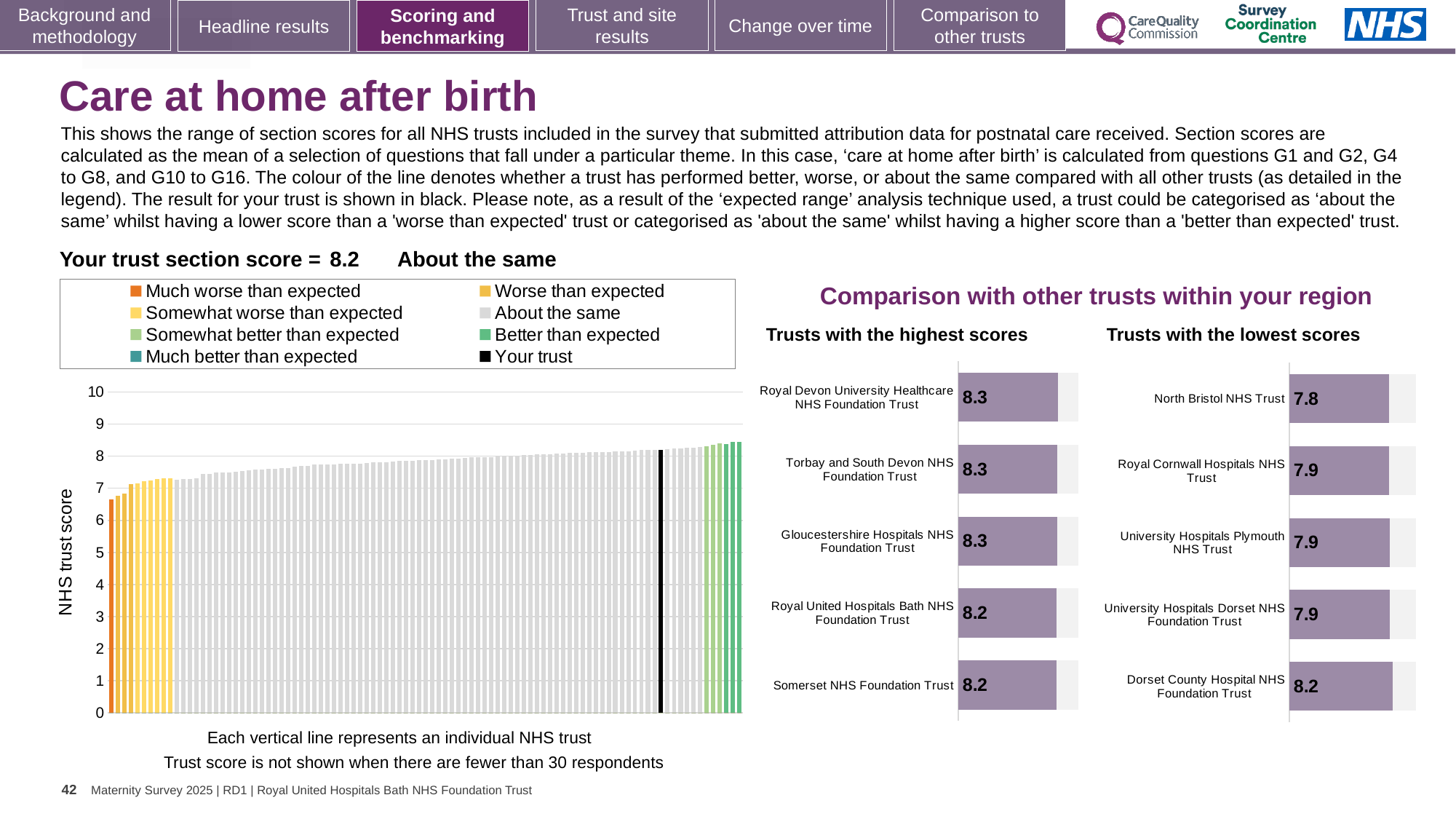
In the large chart on the left, do the bar values rise or fall from left to right? rise How many entries does the legend above the large chart on the left list? 8 In the 'Trusts with the highest scores' chart, what is the score for Royal Devon University Healthcare NHS Foundation Trust? 8.3 In the 'Trusts with the highest scores' chart, what is the score for Somerset NHS Foundation Trust? 8.2 In the 'Trusts with the lowest scores' chart, what is the score for University Hospitals Dorset NHS Foundation Trust? 7.9 In the 'Trusts with the lowest scores' chart, which trust has the highest score? Dorset County Hospital NHS Foundation Trust In the 'Trusts with the lowest scores' chart, what is the score for North Bristol NHS Trust? 7.8 In the large chart on the left, is the value of the leftmost (lowest) bar greater or less than 7? less In the 'Trusts with the highest scores' chart, which has the larger score: Royal Devon University Healthcare NHS Foundation Trust or Somerset NHS Foundation Trust? Royal Devon University Healthcare NHS Foundation Trust In the 'Trusts with the lowest scores' chart, which trust has the lowest score? North Bristol NHS Trust In the 'Trusts with the lowest scores' chart, what is the difference between the scores of Dorset County Hospital NHS Foundation Trust and North Bristol NHS Trust? 0.4 How many trusts are shown in the 'Trusts with the highest scores' chart? 5